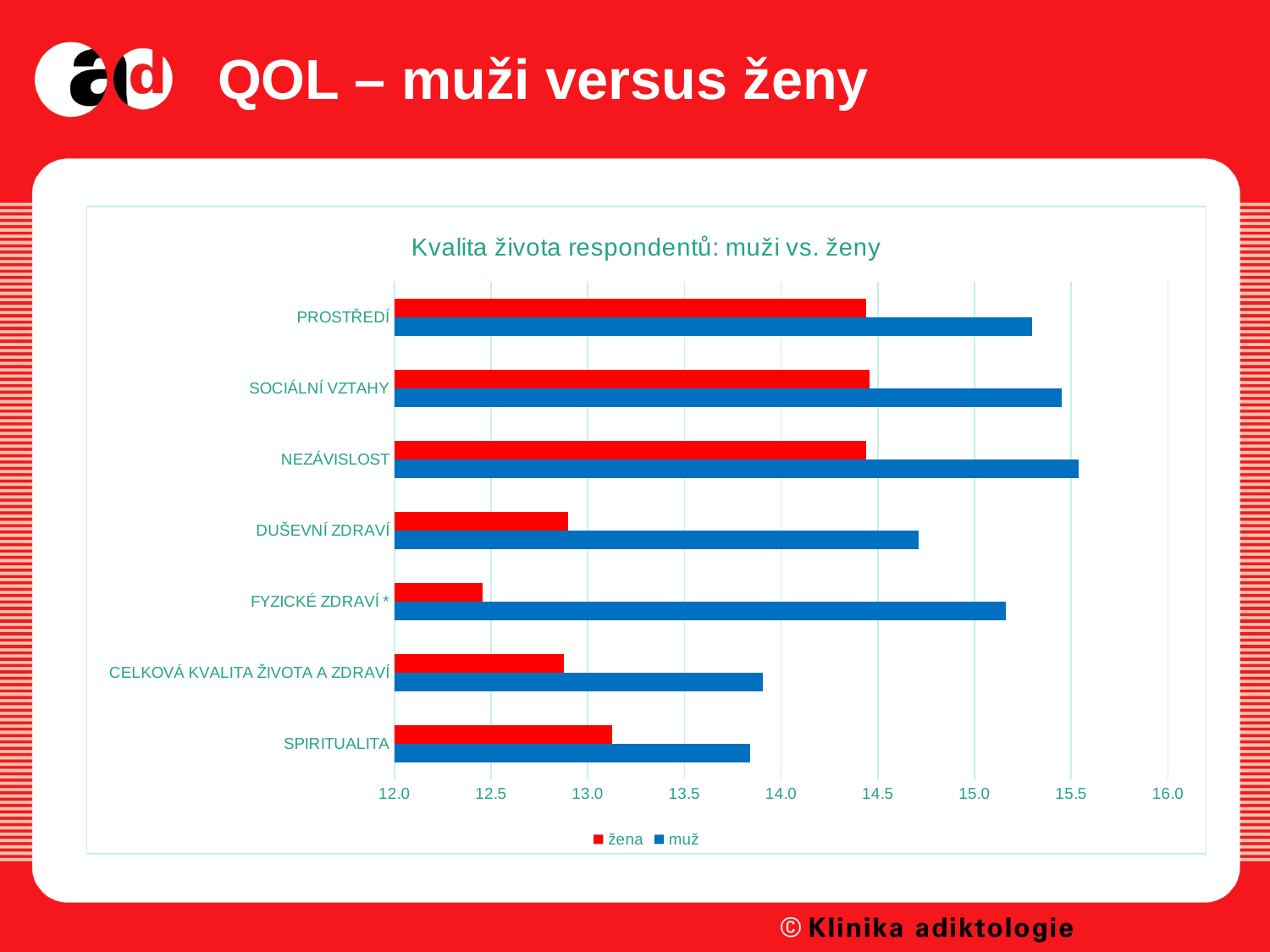
Is the value for muž in FYZICKÉ ZDRAVÍ * greater or less than 15.0? greater What kind of chart is shown on the slide? bar chart Which category has the lowest value for žena? FYZICKÉ ZDRAVÍ * In FYZICKÉ ZDRAVÍ *, which series has the larger value, žena or muž? muž Is the value for žena in DUŠEVNÍ ZDRAVÍ greater or less than 13.0? less How many categories are shown on the chart? 7 For muž, which is larger: FYZICKÉ ZDRAVÍ * or CELKOVÁ KVALITA ŽIVOTA A ZDRAVÍ? FYZICKÉ ZDRAVÍ * How many series does the legend list? 2 What is the title of the chart? Kvalita života respondentů: muži vs. ženy Is the value for muž in SPIRITUALITA greater or less than 14.0? less Which series is shown in red? žena